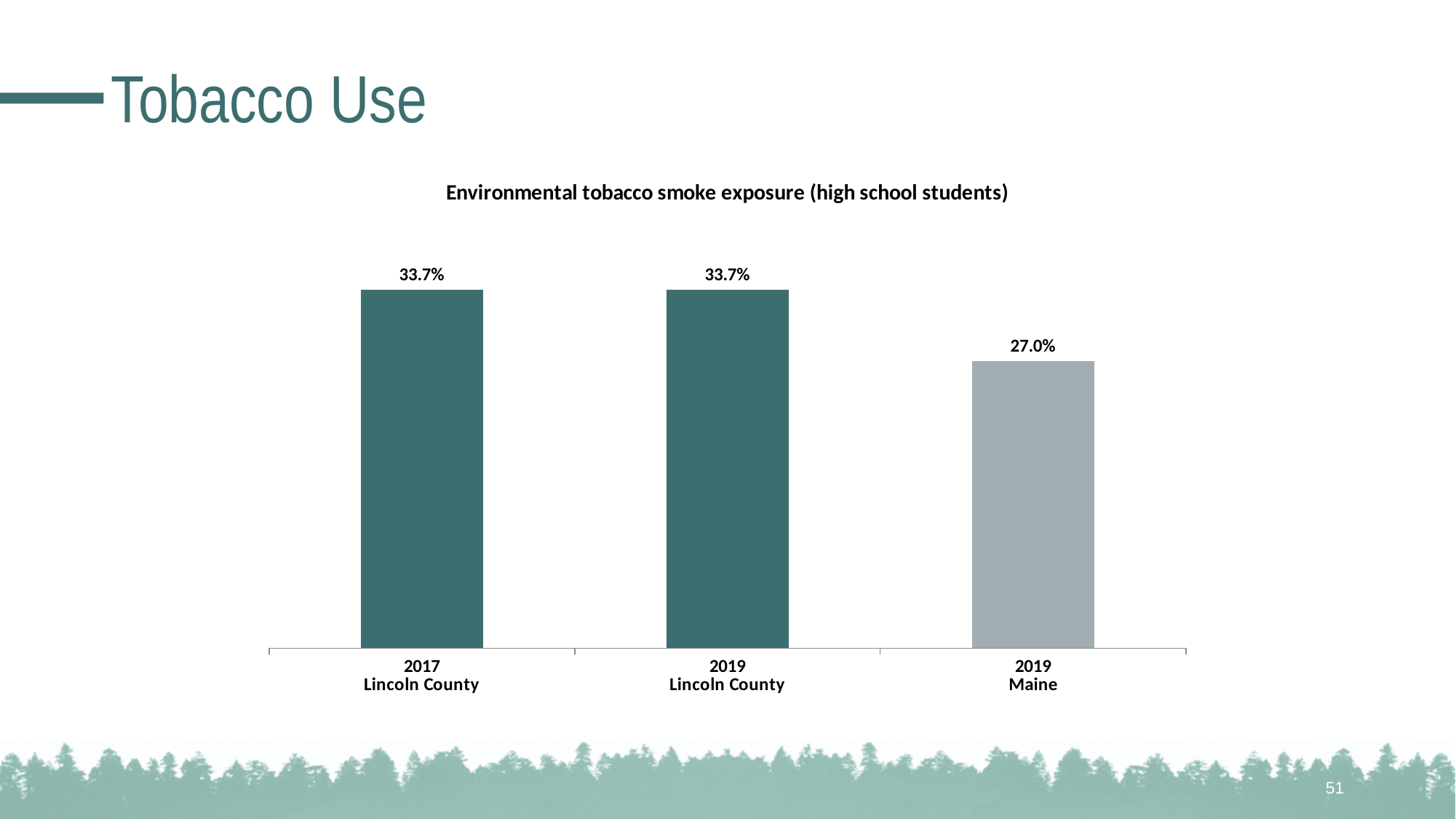
Which is larger, the value for 2019 Lincoln County or the value for 2019 Maine? 2019 Lincoln County What kind of chart is shown on the slide? Bar chart Which category has the lowest value? 2019 Maine How many bars are shown in the chart? 3 What is the value for 2019 Lincoln County? 33.7% Did the Lincoln County value change between 2017 and 2019? No, it stayed at 33.7% What is the value for 2017 Lincoln County? 33.7% What is the title of the chart? Environmental tobacco smoke exposure (high school students) What is the value for 2019 Maine? 27.0% What colour is the bar for 2019 Maine? Grey What is the difference between the 2019 Lincoln County value and the 2019 Maine value? 6.7%